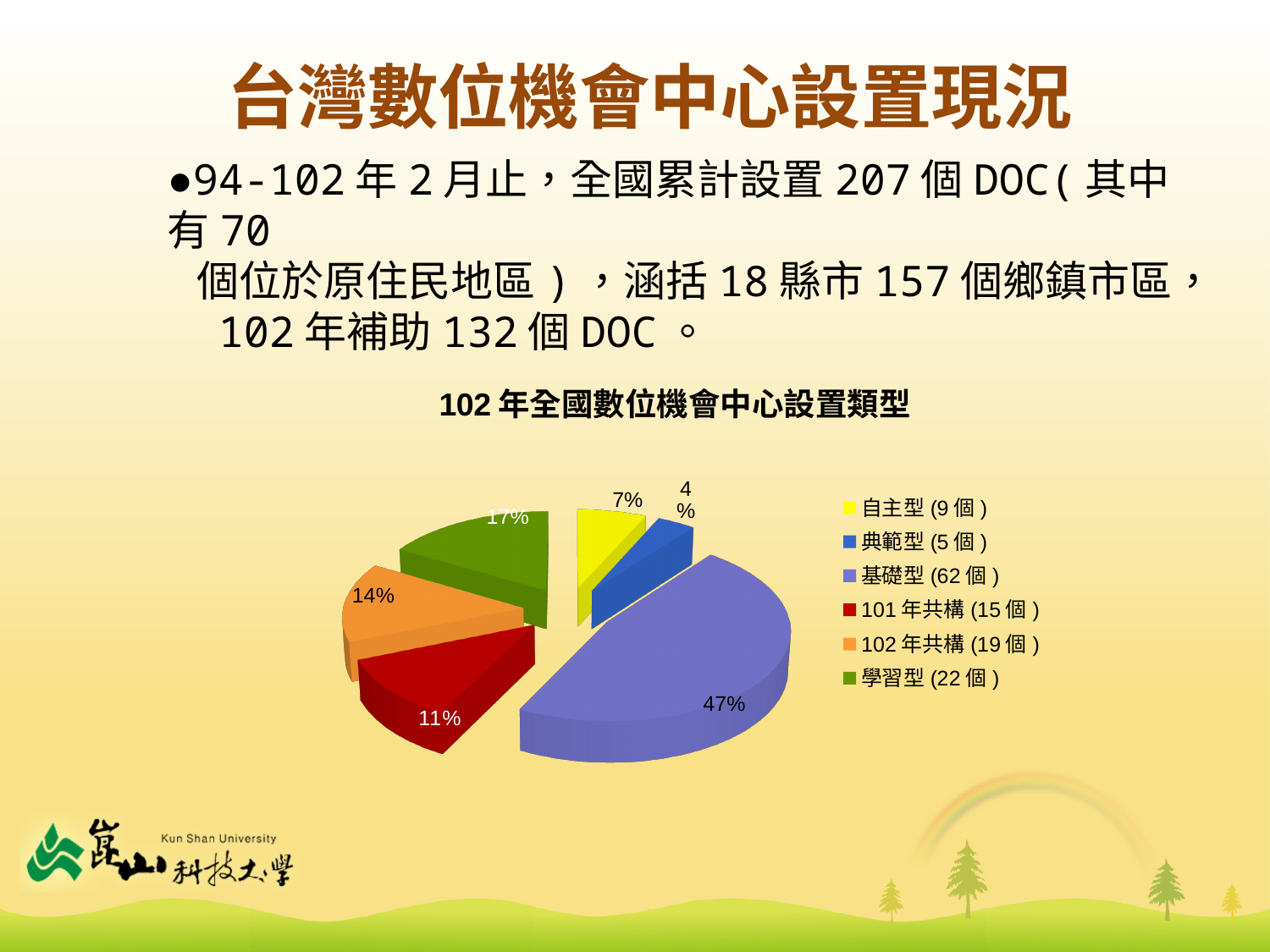
What percentage share does 基礎型 have in the pie chart? 47% What percentage share does 101 年共構 have in the pie chart? 11% What percentage share does 自主型 have in the pie chart? 7% How many slices does the pie chart have? 6 What kind of chart is shown on the slide? pie chart Which category has the smallest share of the pie chart? 典範型 Which category has the largest share of the pie chart? 基礎型 What is the title of the chart? 102 年全國數位機會中心設置類型 Which has a larger share, 學習型 or 102 年共構? 學習型 What is the difference in percentage points between the shares of 基礎型 and 學習型? 30